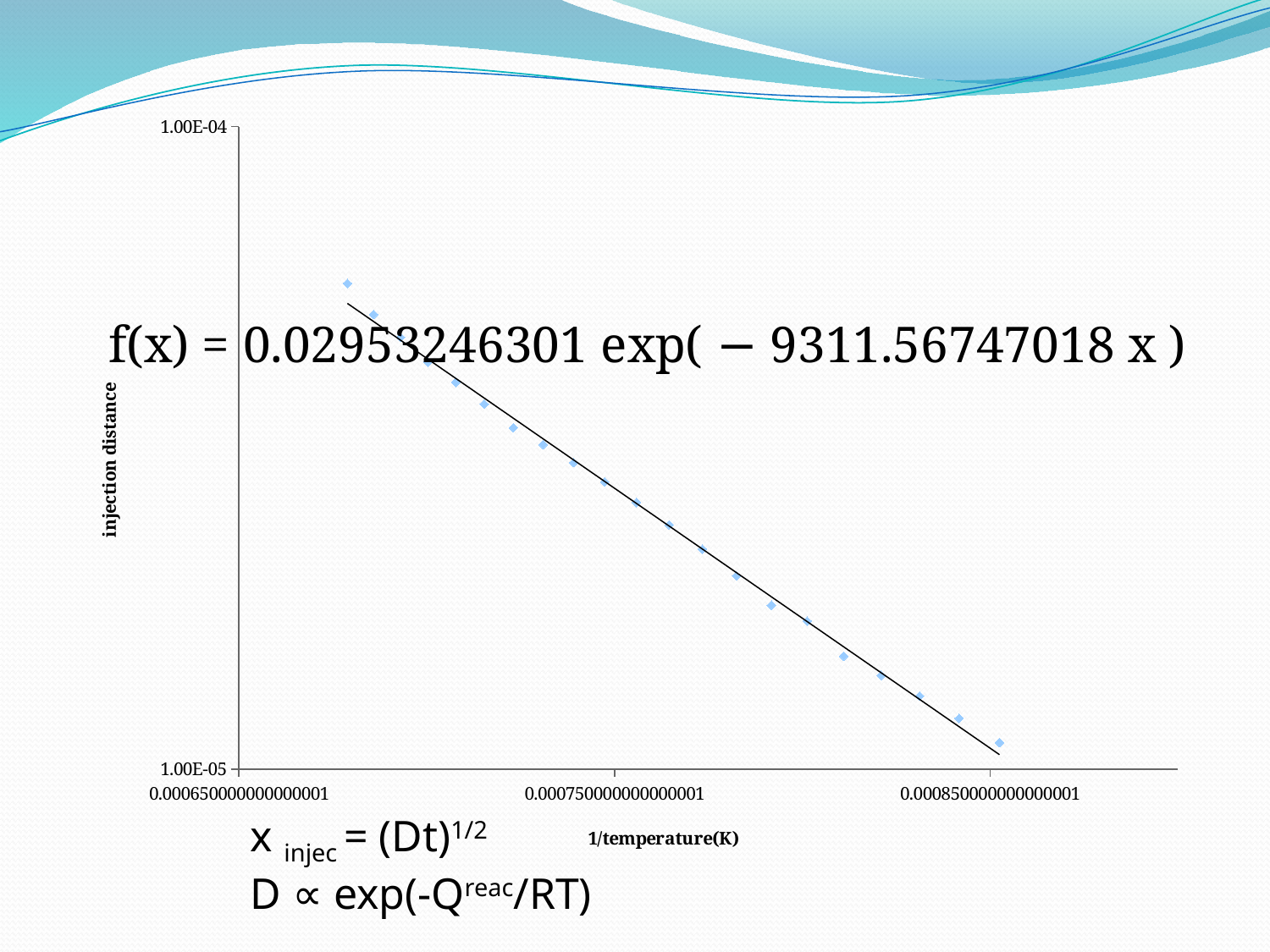
What is the exponent coefficient in the trendline equation? −9311.56747018 Is the injection distance at 1/temperature(K) = 0.00085 greater or less than 1.00E-05? greater What is the fitted trendline equation shown on the chart? f(x) = 0.02953246301 exp( − 9311.56747018 x ) Do the plotted values rise or fall as 1/temperature(K) increases along the x axis? fall Which data point has the higher injection distance: the leftmost point or the rightmost point? the leftmost point What is the label of the x axis? 1/temperature(K) What is the lowest value shown on the y axis? 1.00E-05 What is the pre-exponential coefficient in the trendline equation? 0.02953246301 Is the injection distance of the leftmost data point greater or less than 1.00E-04? less What is the highest value shown on the y axis? 1.00E-04 What kind of chart is shown on the slide? scatter chart What is the label of the y axis? injection distance